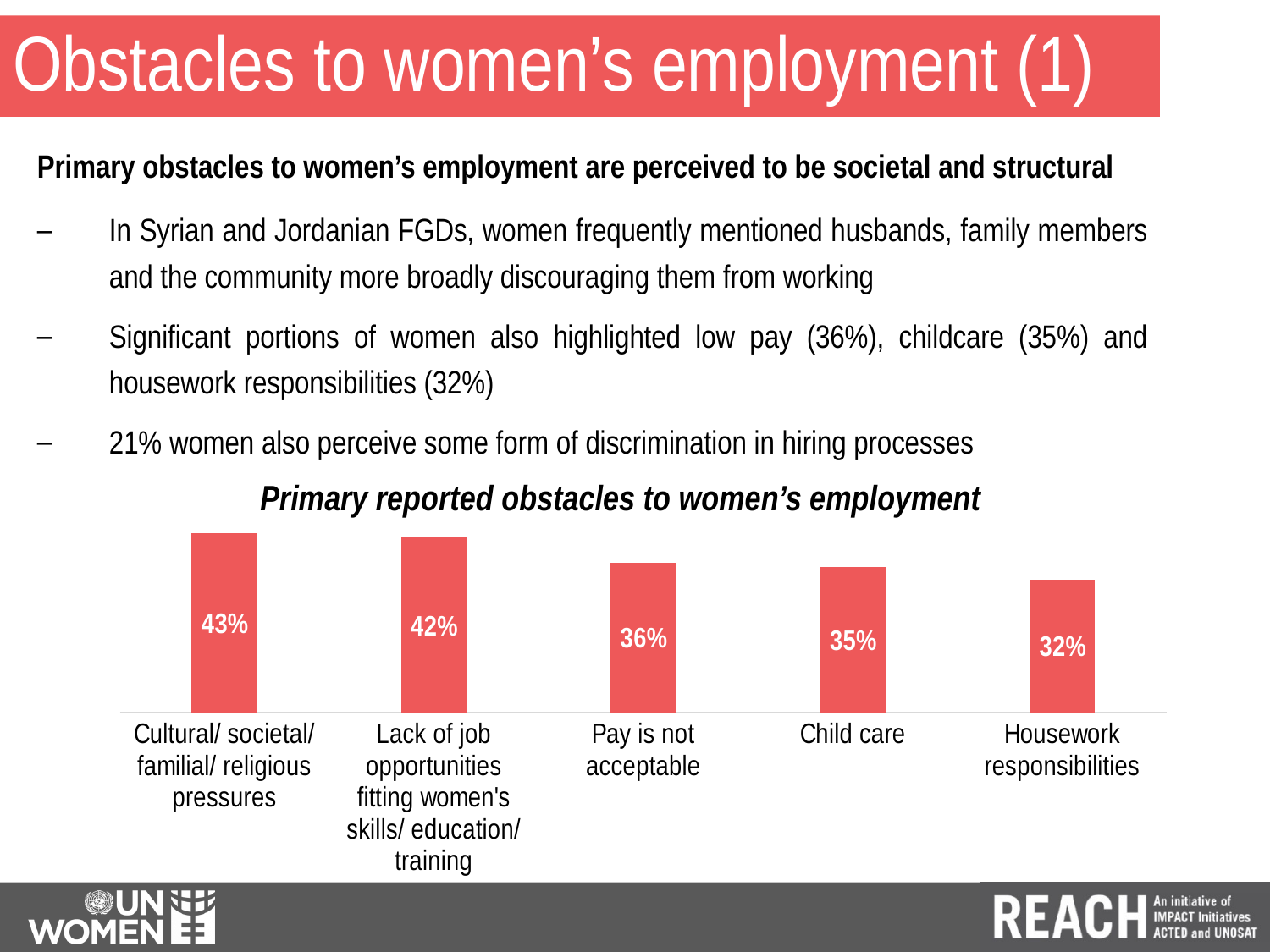
What is the title of the chart? Primary reported obstacles to women's employment What is the difference in percentage points between 'Cultural/ societal/ familial/ religious pressures' and 'Housework responsibilities'? 11 Which is larger: the value for 'Child care' or the value for 'Housework responsibilities'? Child care What is the value shown for 'Pay is not acceptable'? 36% Which obstacle has the lowest reported percentage? Housework responsibilities What is the difference between the values for 'Pay is not acceptable' and 'Child care'? 1 What percentage of women reported cultural/societal/familial/religious pressures as an obstacle to employment? 43% What percentage is shown for 'Housework responsibilities'? 32% What is the value for 'Lack of job opportunities fitting women's skills/education/training'? 42% What type of chart is used to show the primary reported obstacles? Bar chart Which obstacle has the highest reported percentage? Cultural/ societal/ familial/ religious pressures How many obstacle categories are shown in the chart? 5